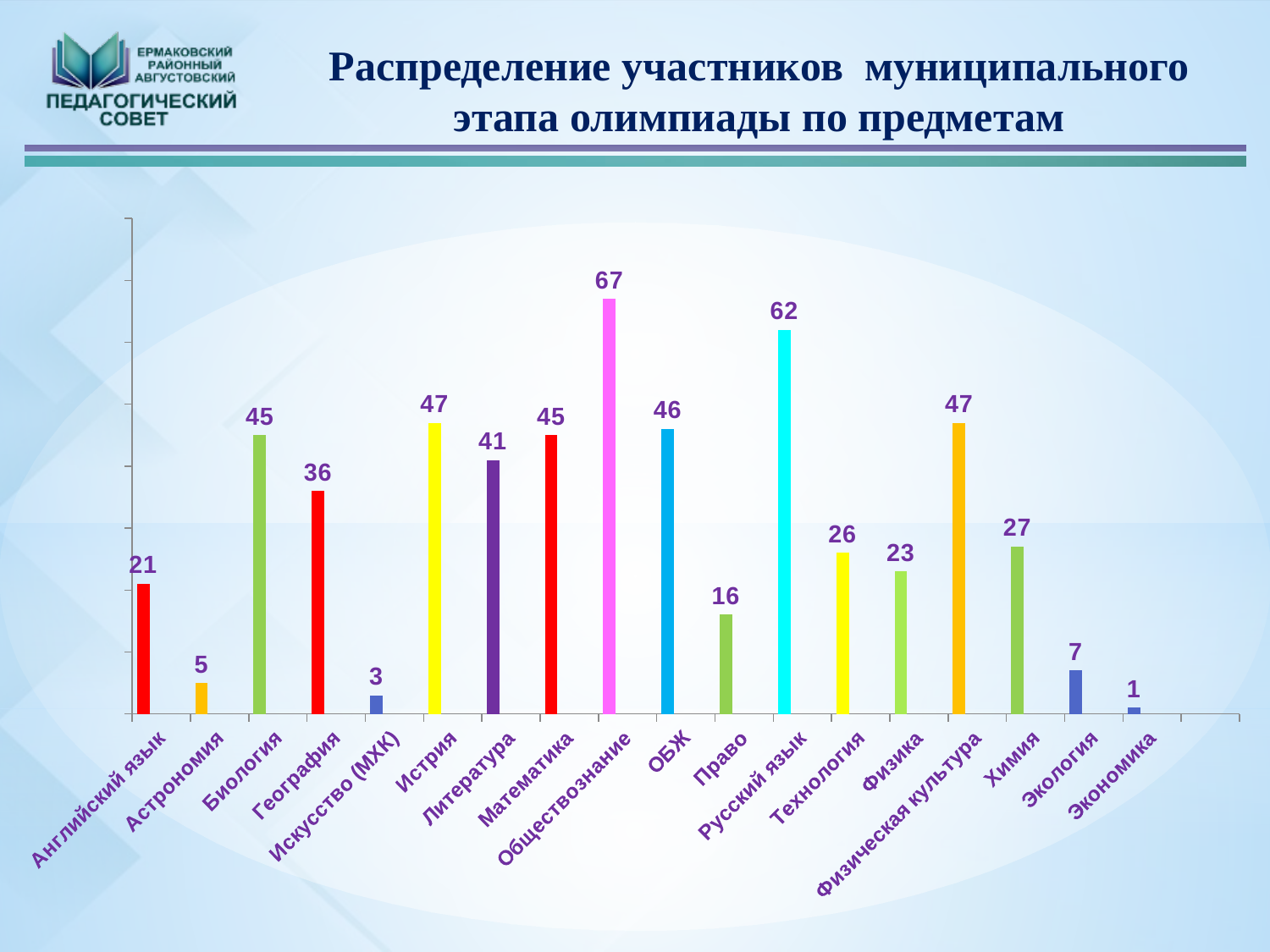
What is the difference between the values for Химия and Физика? 4 What is the value for Русский язык? 62 Which subject has the highest value? Обществознание What is the value for Обществознание? 67 What kind of chart is shown on the slide? bar chart What is the value for Английский язык? 21 What is the difference between the values for Обществознание and Русский язык? 5 Which subject has the lowest value? Экономика What is the value for Физическая культура? 47 How many subjects (categories) are shown in the chart? 18 What is the title of the chart on the slide? Распределение участников муниципального этапа олимпиады по предметам Which is larger, the value for География or the value for Литература? Литература